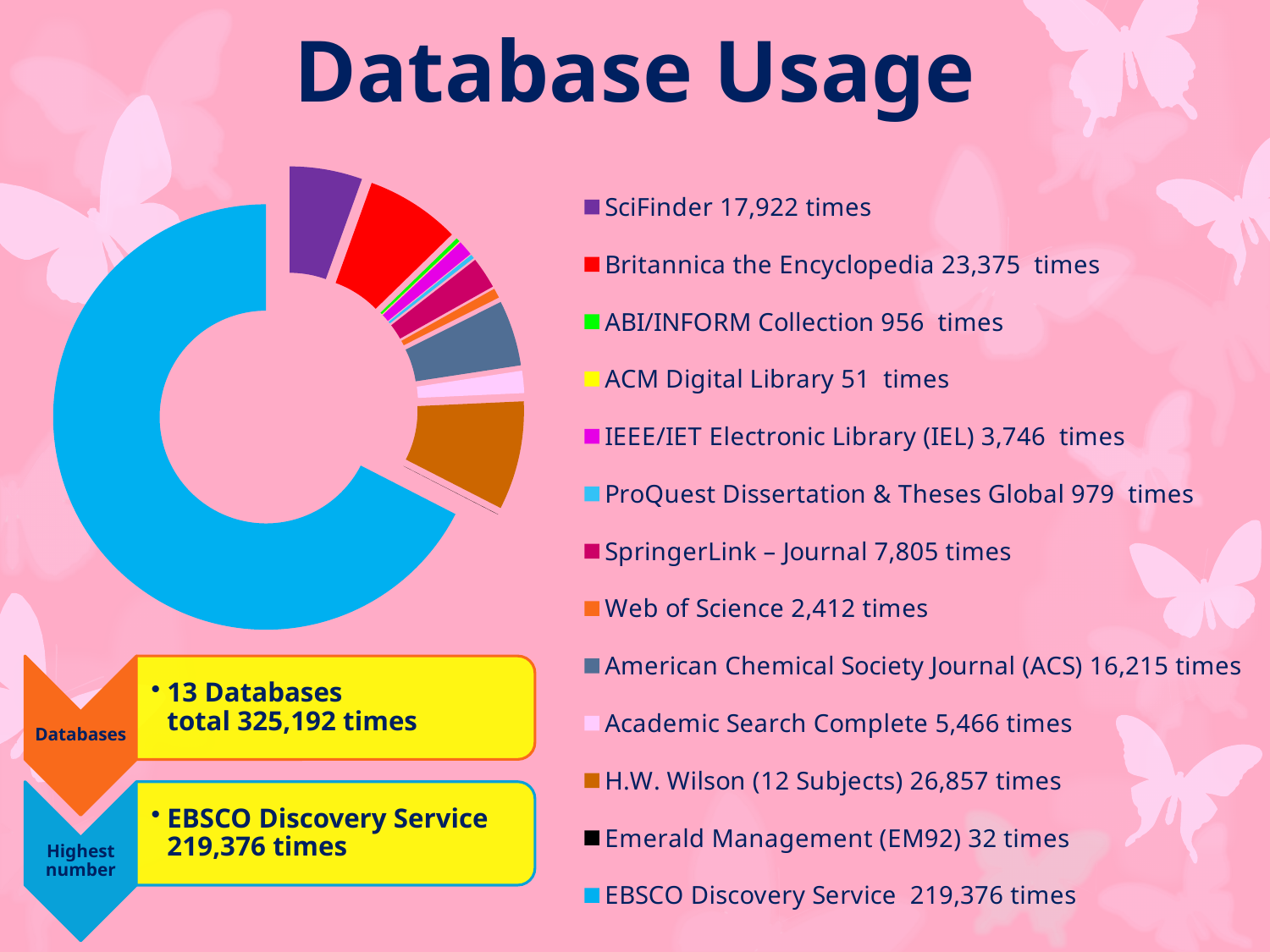
What is the title of the slide containing the chart? Database Usage Which database has the highest usage? EBSCO Discovery Service How many times was SciFinder used? 17,922 times What kind of chart is shown on the slide? Doughnut (pie) chart Which database has the lowest usage? Emerald Management (EM92) What is the difference in usage between Britannica the Encyclopedia and SciFinder? 5,453 times How many times was H.W. Wilson (12 Subjects) used? 26,857 times What is the difference in usage between EBSCO Discovery Service and H.W. Wilson (12 Subjects)? 192,519 times Which was used more, American Chemical Society Journal (ACS) or SpringerLink – Journal? American Chemical Society Journal (ACS) How many times was Emerald Management (EM92) used? 32 times How many databases are shown in the chart? 13 What is the total usage across all 13 databases? 325,192 times